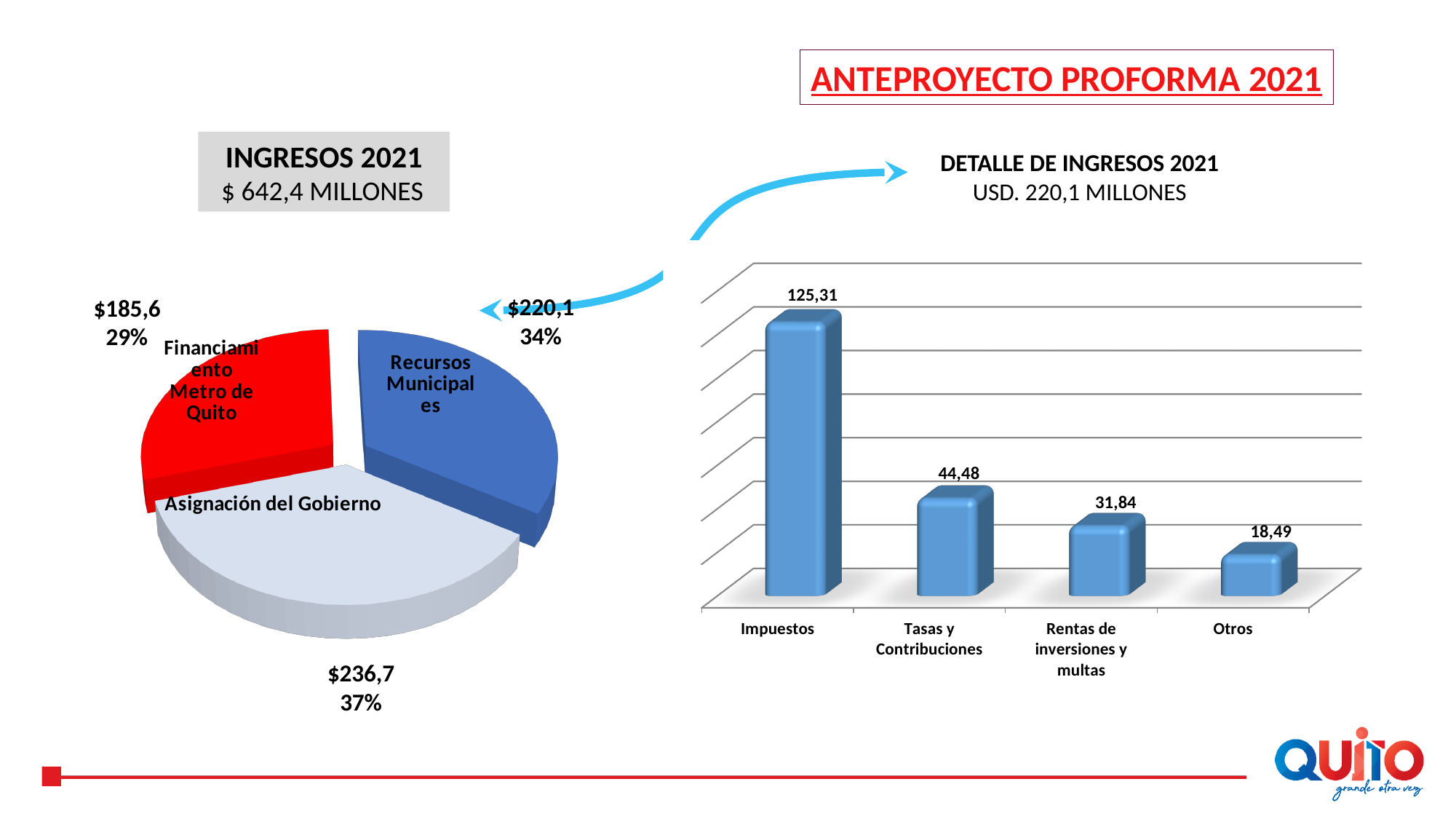
In the INGRESOS 2021 pie chart, which slice is the smallest? Financiamiento Metro de Quito What kind of chart is the DETALLE DE INGRESOS 2021 chart on the right? Bar chart How many slices does the INGRESOS 2021 pie chart have? 3 In the INGRESOS 2021 pie chart, what percentage share does Asignación del Gobierno have? 37% In the DETALLE DE INGRESOS 2021 bar chart, what is the value for Rentas de inversiones y multas? 31,84 In the DETALLE DE INGRESOS 2021 bar chart, do the values rise or fall from left to right? Fall In the DETALLE DE INGRESOS 2021 bar chart, what is the difference between Impuestos and Tasas y Contribuciones? 80,83 In the INGRESOS 2021 pie chart, what value is shown for Financiamiento Metro de Quito? $185,6 In the DETALLE DE INGRESOS 2021 bar chart, which category has the lowest value? Otros In the DETALLE DE INGRESOS 2021 bar chart, what is the value for Impuestos? 125,31 In the INGRESOS 2021 pie chart, which slice is the largest? Asignación del Gobierno In the INGRESOS 2021 pie chart, what value is shown for Recursos Municipales? $220,1